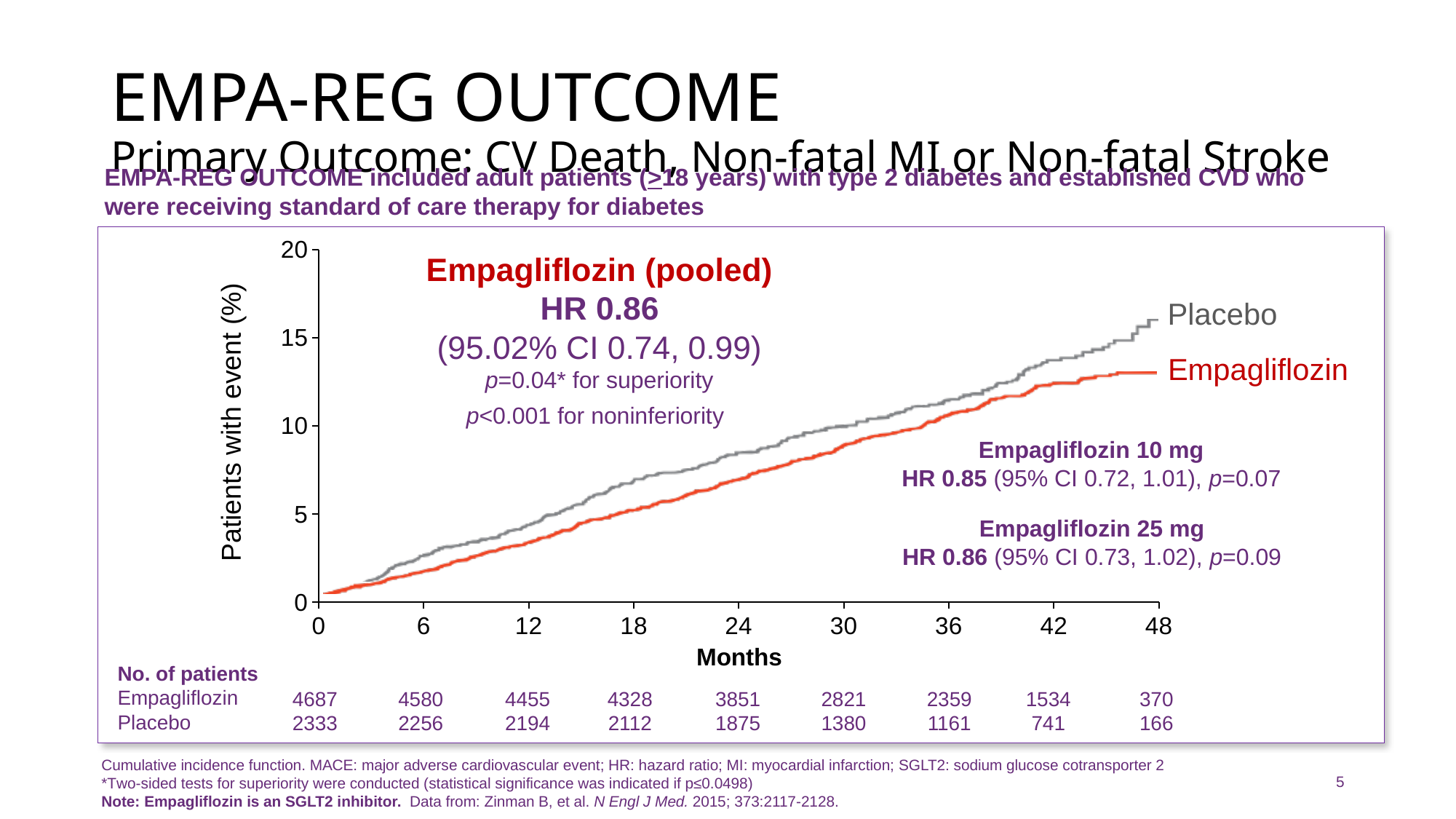
What is the difference between the number of Empagliflozin and Placebo patients at 0 months in the No. of patients table? 2354 According to the No. of patients table, how many Empagliflozin patients were at risk at 0 months? 4687 What hazard ratio is shown for Empagliflozin (pooled) on the chart? HR 0.86 According to the No. of patients table, how many Placebo patients were at risk at 48 months? 166 Is the Placebo curve at 24 months greater or less than 10%? less How many treatment groups (series) are plotted on the chart? 2 Is the Placebo curve at 48 months greater or less than 15%? greater Is the Empagliflozin curve at 48 months greater or less than 15%? less According to the No. of patients table, how many Placebo patients were at risk at 24 months? 1875 Do the cumulative incidence curves rise or fall as months increase? Rise What kind of chart is shown on the slide? Line chart At 48 months, which curve is higher: Placebo or Empagliflozin? Placebo